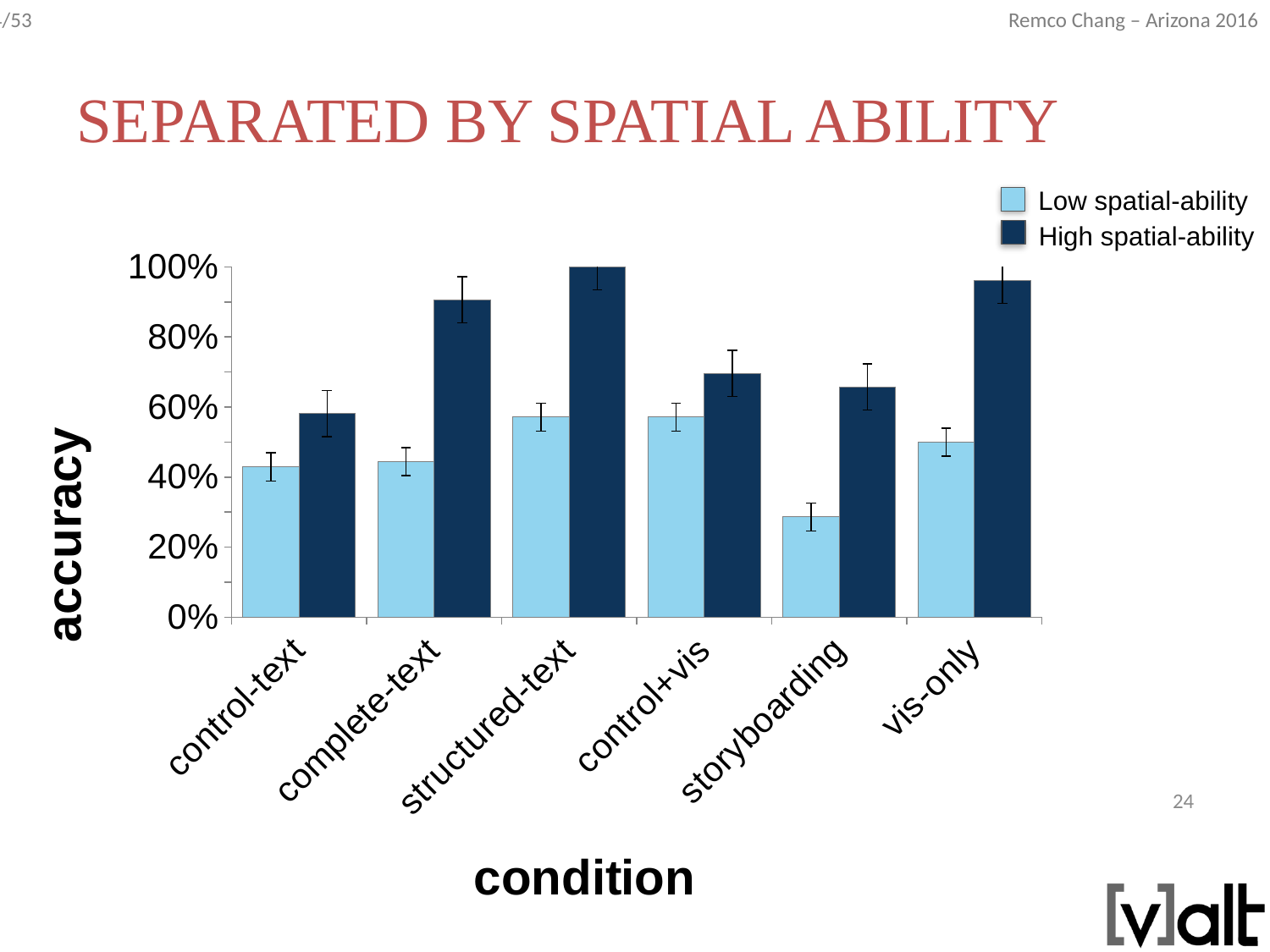
Is the High spatial-ability accuracy for complete-text greater or less than 80%? greater Is the Low spatial-ability accuracy for control-text greater or less than 60%? less Which condition has the highest accuracy for the High spatial-ability series? structured-text For the storyboarding condition, which series has the larger accuracy: Low spatial-ability or High spatial-ability? High spatial-ability Which condition has the lowest accuracy for the Low spatial-ability series? storyboarding Is the High spatial-ability accuracy for control+vis greater or less than 60%? greater What kind of chart is shown on the slide? bar chart What is the label on the y axis of the chart? accuracy Which has the larger Low spatial-ability accuracy: control-text or storyboarding? control-text How many conditions are shown along the x axis of the chart? 6 How many series does the chart's legend list? 2